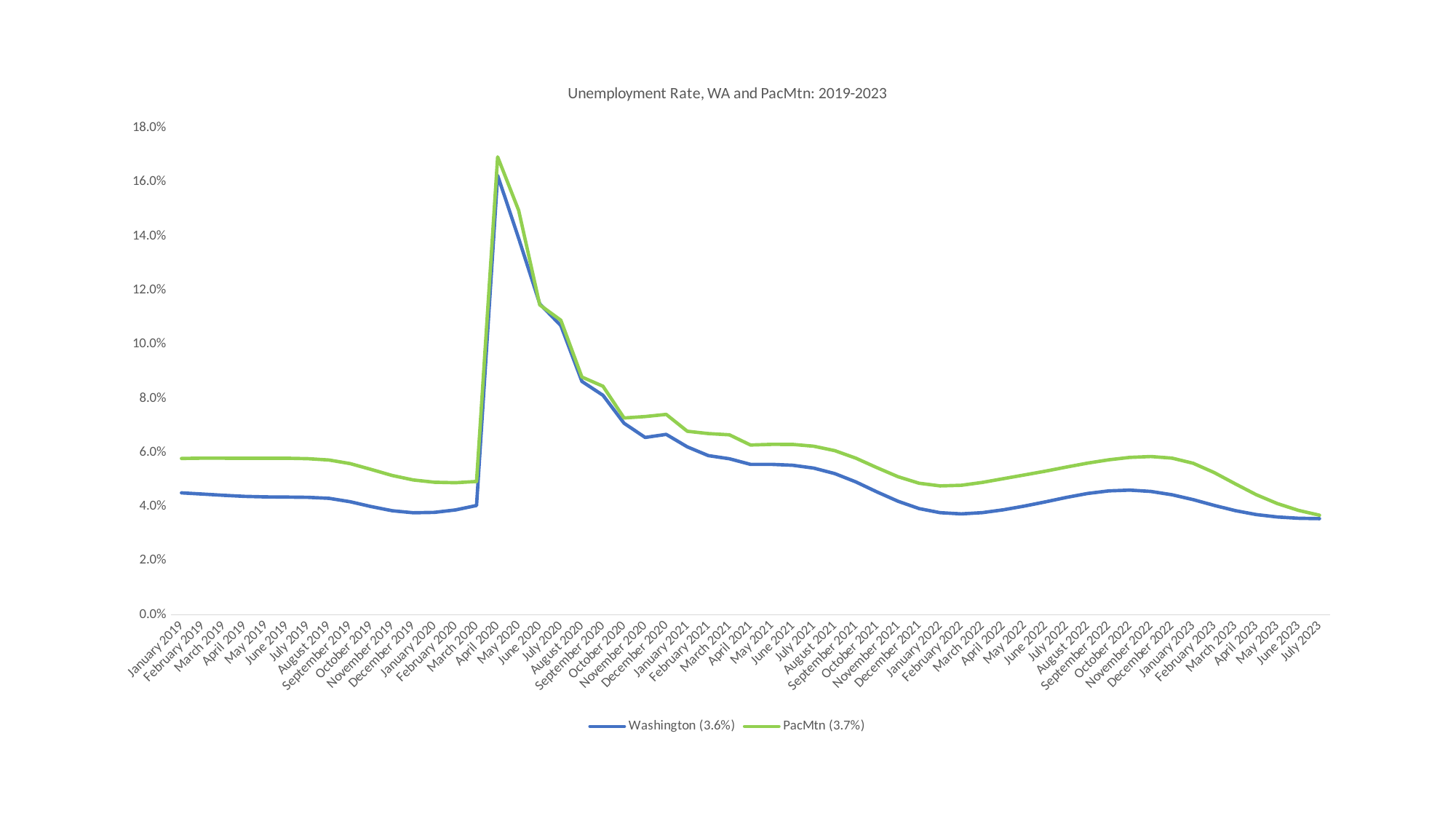
What kind of chart is shown on the slide? line chart In which month does the PacMtn series reach its highest value? April 2020 In which month does the Washington series reach its highest value? April 2020 Do the values for Washington rise or fall from April 2020 to December 2020? fall How many series does the legend list? 2 Is the value for PacMtn in April 2020 greater or less than 16.0%? greater Is the value for Washington in January 2019 greater or less than 4.0%? greater How many months are plotted along the x axis? 55 Is the value for PacMtn in January 2019 greater or less than 6.0%? less What percentage is shown in the legend entry for Washington? 3.6% What is the title of the chart? Unemployment Rate, WA and PacMtn: 2019-2023 Which series has the higher value in January 2019, Washington or PacMtn? PacMtn